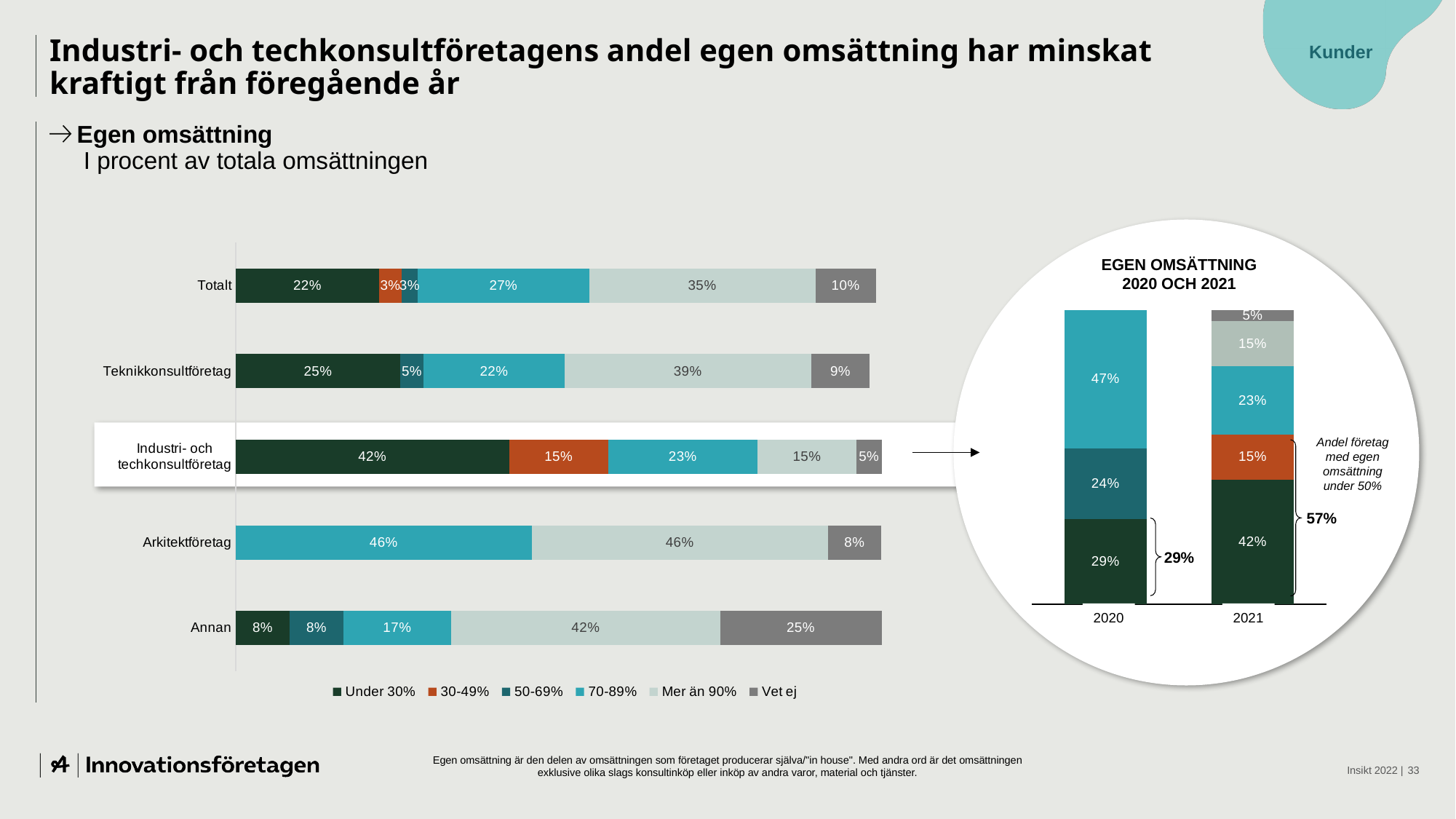
In the 'EGEN OMSÄTTNING 2020 OCH 2021' chart, what is the value of the top (70-89%) segment for 2020? 47% In the main bar chart, what is the 'Mer än 90%' value for Teknikkonsultföretag? 39% In the 'EGEN OMSÄTTNING 2020 OCH 2021' chart, what share of companies had own revenue under 50% in 2021, according to the bracket label? 57% In the main bar chart, which category has the largest 'Under 30%' segment? Industri- och techkonsultföretag How many categories are shown on the main bar chart? 5 In the main bar chart, what is the value of the 'Under 30%' segment for Industri- och techkonsultföretag? 42% How many series does the legend of the main bar chart list? 6 What type of chart is the main chart on the slide? Bar chart In the main bar chart, what is the 'Vet ej' value for Annan? 25% In the main bar chart, which has the larger 'Mer än 90%' segment, Annan or Totalt? Annan In the main bar chart, how many percentage points larger is the 'Under 30%' segment for Industri- och techkonsultföretag than for Totalt? 20 percentage points In the 'EGEN OMSÄTTNING 2020 OCH 2021' chart, what is the value of the bottom (Under 30%) segment for 2021? 42%